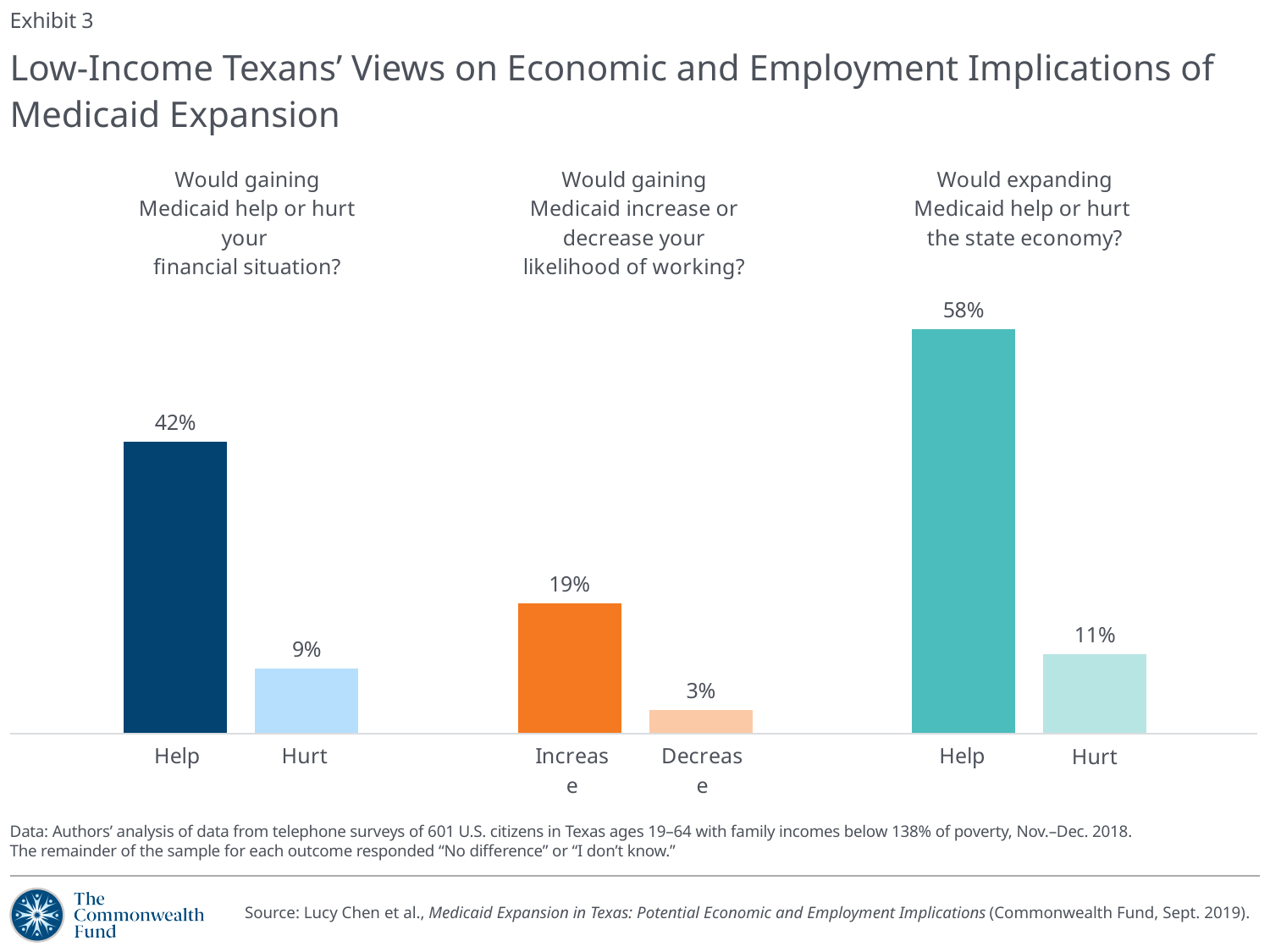
What is the difference between the Help and Hurt percentages for the financial situation question? 33 percentage points What percentage of low-income Texans said gaining Medicaid would help their financial situation? 42% Which bar on the slide has the highest value? Help (state economy), 58% What percentage said expanding Medicaid would hurt the state economy? 11% Which is larger: the share saying Medicaid would help their financial situation or the share saying it would help the state economy? Help the state economy (58%) What percentage said expanding Medicaid would help the state economy? 58% What is the difference between the Help and Hurt percentages for the state economy question? 47 percentage points What percentage said gaining Medicaid would decrease their likelihood of working? 3% Which bar on the slide has the lowest value? Decrease (likelihood of working), 3% What percentage said gaining Medicaid would hurt their financial situation? 9% What percentage said gaining Medicaid would increase their likelihood of working? 19% What type of chart is shown on the slide? Bar chart